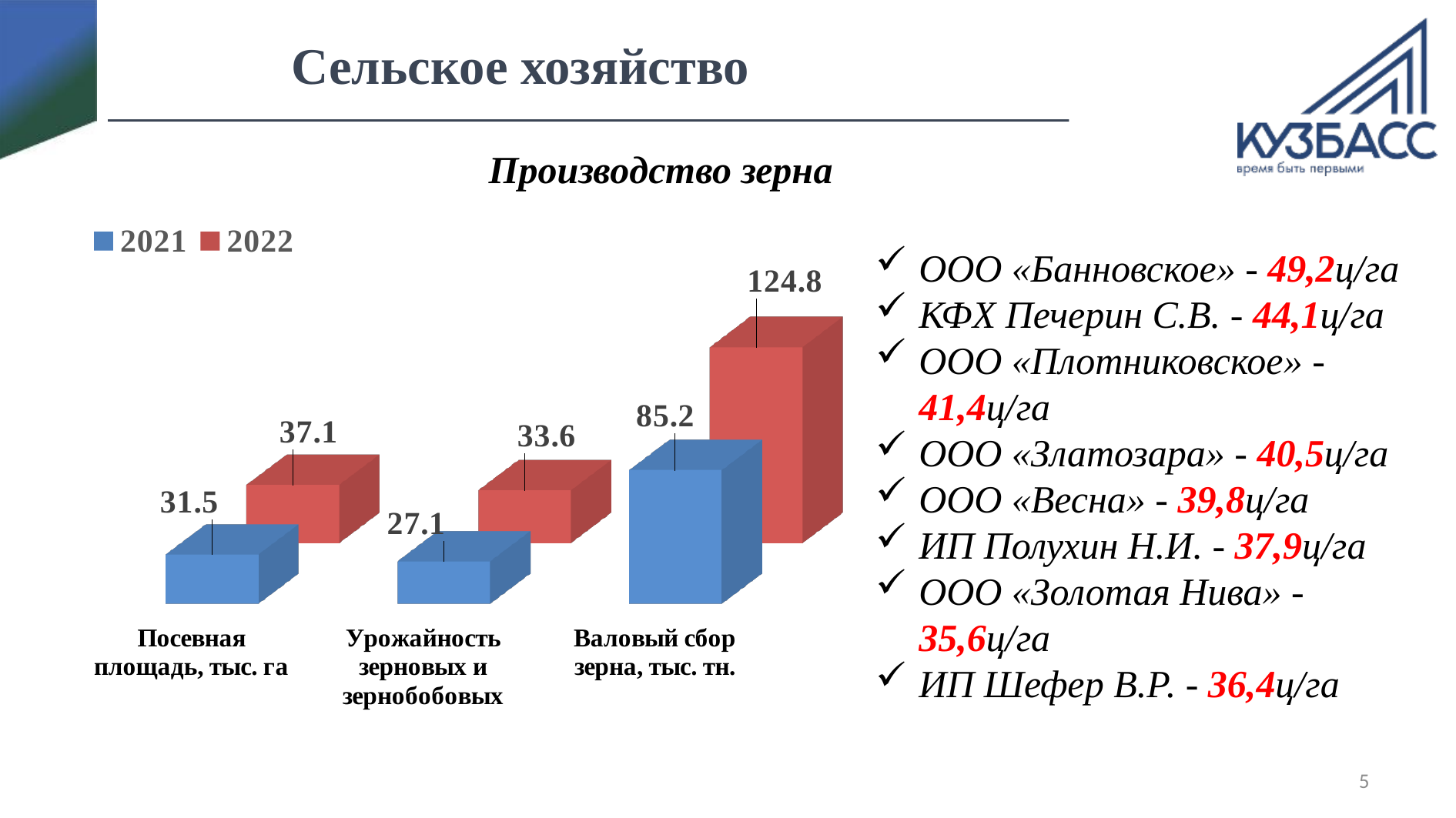
What is the difference between the 2022 and 2021 values for Урожайность зерновых и зернобобовых? 6.5 What is the 2022 value for Посевная площадь, тыс. га? 37.1 Which category has the highest 2022 value? Валовый сбор зерна, тыс. тн. What is the 2021 value for Урожайность зерновых и зернобобовых? 27.1 What is the difference between the 2022 and 2021 values for Валовый сбор зерна, тыс. тн.? 39.6 What type of chart is shown on the slide? Bar chart What is the 2022 value for Валовый сбор зерна, тыс. тн.? 124.8 Which category has the lowest 2021 value? Урожайность зерновых и зернобобовых Which is larger for Посевная площадь, тыс. га: the 2021 value or the 2022 value? 2022 What is the 2021 value for Посевная площадь, тыс. га? 31.5 How many categories are shown on the x axis of the chart? 3 How many series does the chart legend list? 2